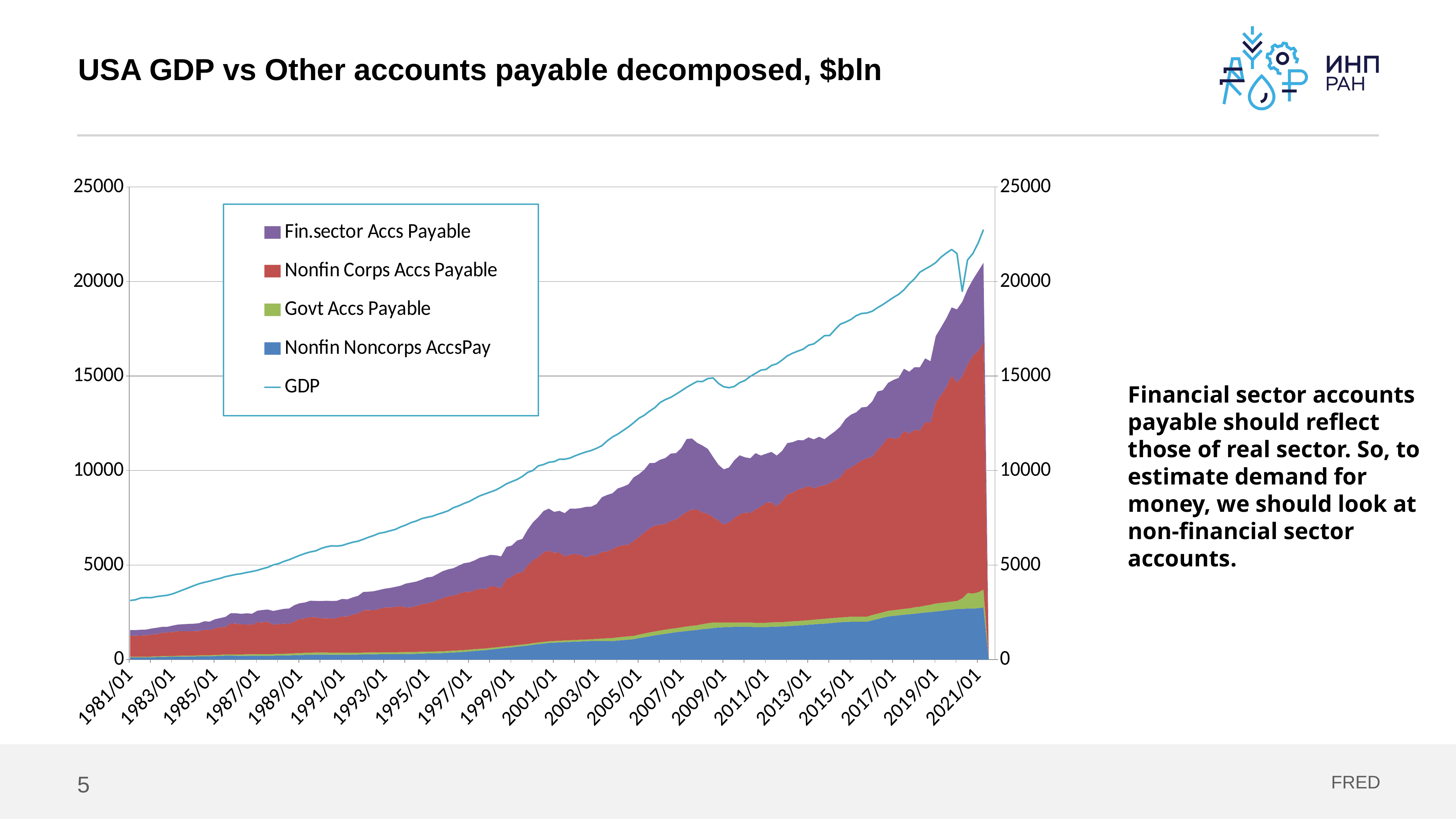
Is the GDP value at 2021/01 greater or less than 20000? greater Is the value for Nonfin Noncorps AccsPay at 2021/01 greater or less than 5000? less Which accounts payable series is the smallest component of the stack at 2021/01? Govt Accs Payable At 2009/01, which is larger: GDP or the total of the stacked accounts payable? GDP Which colour represents Fin.sector Accs Payable in the chart? Purple How many series does the legend list? 5 Which accounts payable series is the largest component of the stack at 2021/01? Nonfin Corps Accs Payable What kind of chart is shown on the slide? Stacked area chart with a line What is the title of the chart? USA GDP vs Other accounts payable decomposed, $bln Is the GDP value at 1981/01 greater or less than 5000? less Does GDP rise or fall along the x axis from 1981/01 to 2021/01? Rise